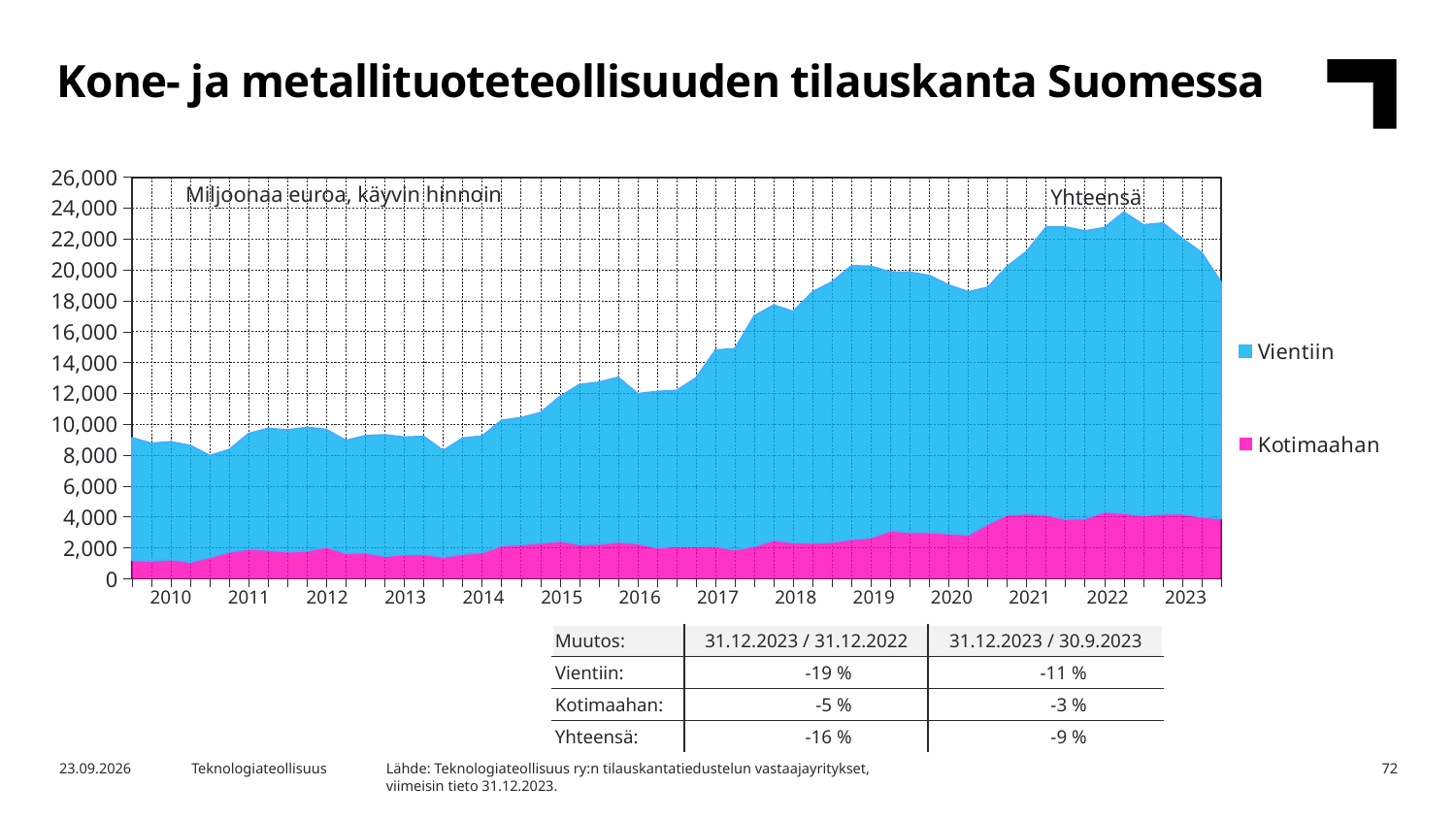
How many series does the chart legend list? 2 Is the Kotimaahan value at the start of 2010 greater or less than 2,000? less How many years are labelled on the x axis of the chart? 14 What are the two series named in the chart legend? Vientiin and Kotimaahan Which series is larger throughout the chart, Vientiin or Kotimaahan? Vientiin Does the total order backlog (Yhteensä) generally rise or fall from 2010 to 2022? rise Is the total (Yhteensä) value at the end of 2023 greater or less than 20,000? less What type of chart is shown on the slide? Stacked area chart Is the total (Yhteensä) value at the start of 2010 greater or less than 8,000? greater What unit is stated in the label at the top left of the chart area? Miljoonaa euroa, käyvin hinnoin